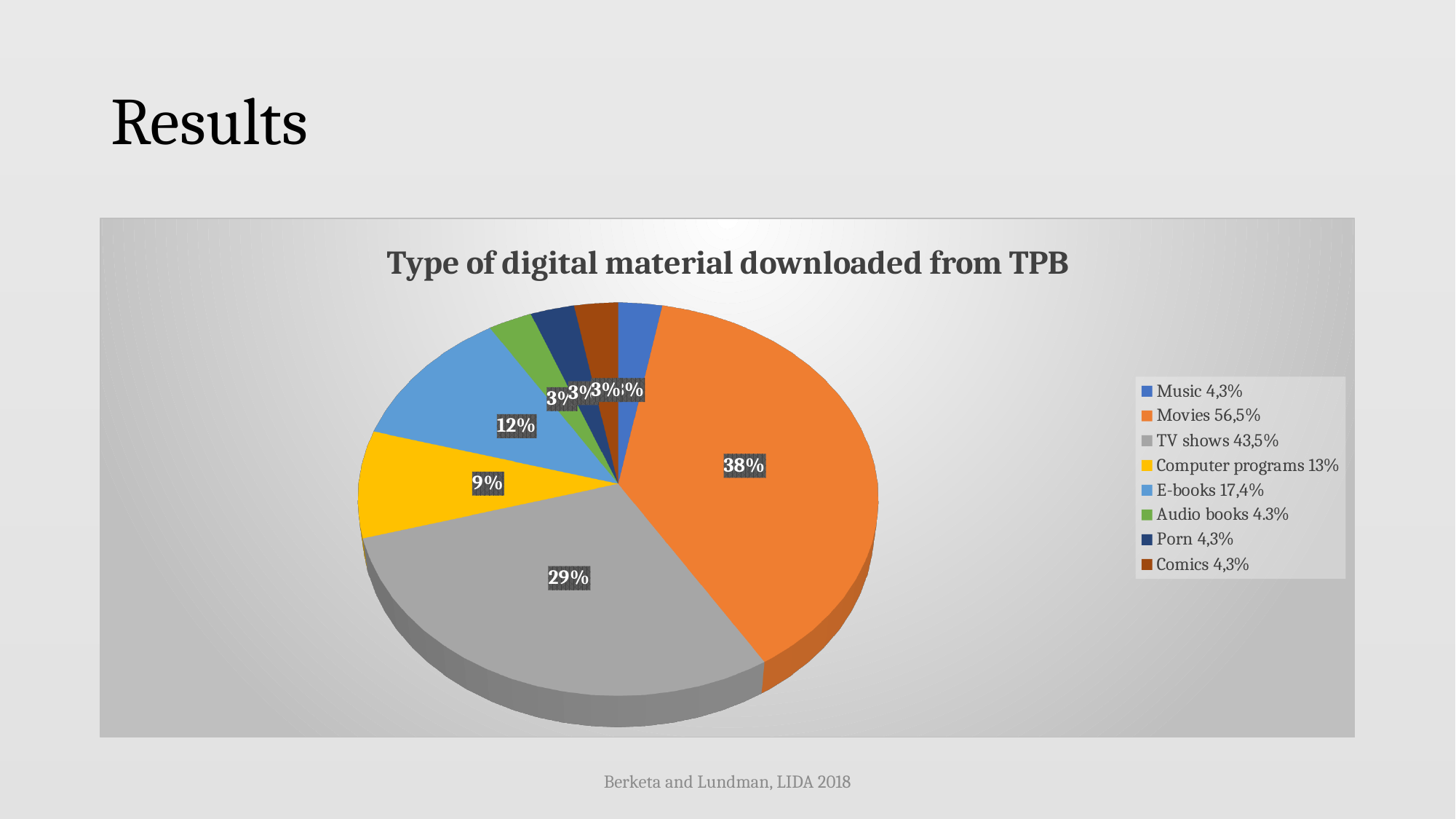
What percentage label is shown on the TV shows slice? 29% What percentage label is shown on the Computer programs slice? 9% How many categories does the pie chart have? 8 What is the difference between the slice labels for Movies and TV shows? 9% According to the legend, what value is listed for Movies? 56,5% What kind of chart is shown on the slide? pie chart According to the legend, what value is listed for E-books? 17,4% What percentage label is shown on the E-books slice? 12% Which category has the largest slice of the pie? Movies What percentage label is shown on the Movies slice? 38% What is the title of the chart? Type of digital material downloaded from TPB Which slice is larger, E-books or Computer programs? E-books